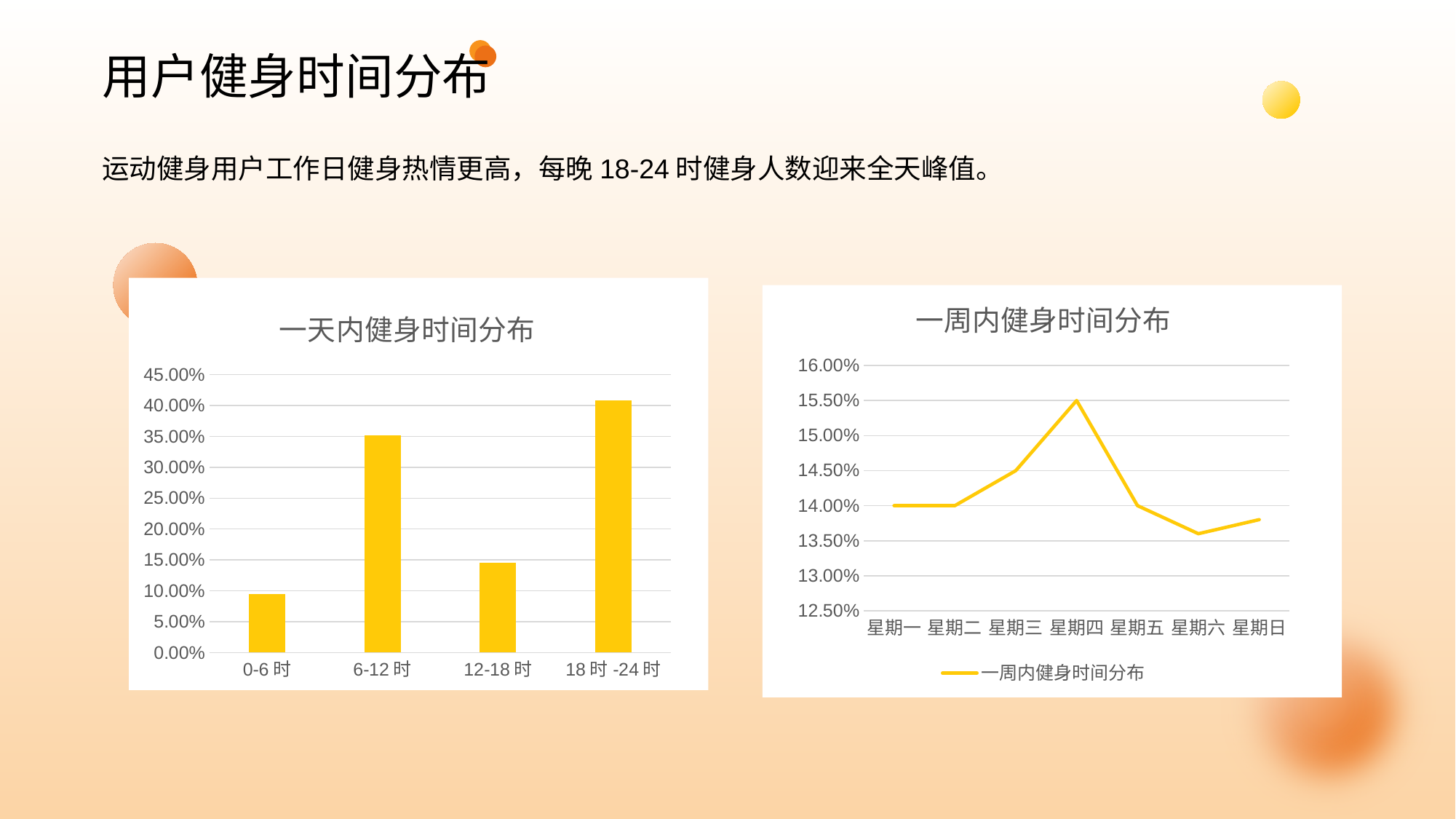
In the chart 一天内健身时间分布, is the value for 6-12 时 greater or less than 30.00%? greater In the chart 一天内健身时间分布, which time period has the lowest value? 0-6 时 In the chart 一周内健身时间分布, what is the value for 星期四? 15.50% What type of chart is the right chart titled 一周内健身时间分布? line chart In the chart 一周内健身时间分布, which day has the highest value? 星期四 In the chart 一天内健身时间分布, which is larger, the value for 6-12 时 or the value for 12-18 时? 6-12 时 In the chart 一天内健身时间分布, how many time periods are shown on the x axis? 4 In the chart 一周内健身时间分布, which day has the lowest value? 星期六 In the chart 一天内健身时间分布, which time period has the highest value? 18 时 -24 时 What type of chart is the left chart titled 一天内健身时间分布? bar chart In the chart 一周内健身时间分布, how many series does the legend list? 1